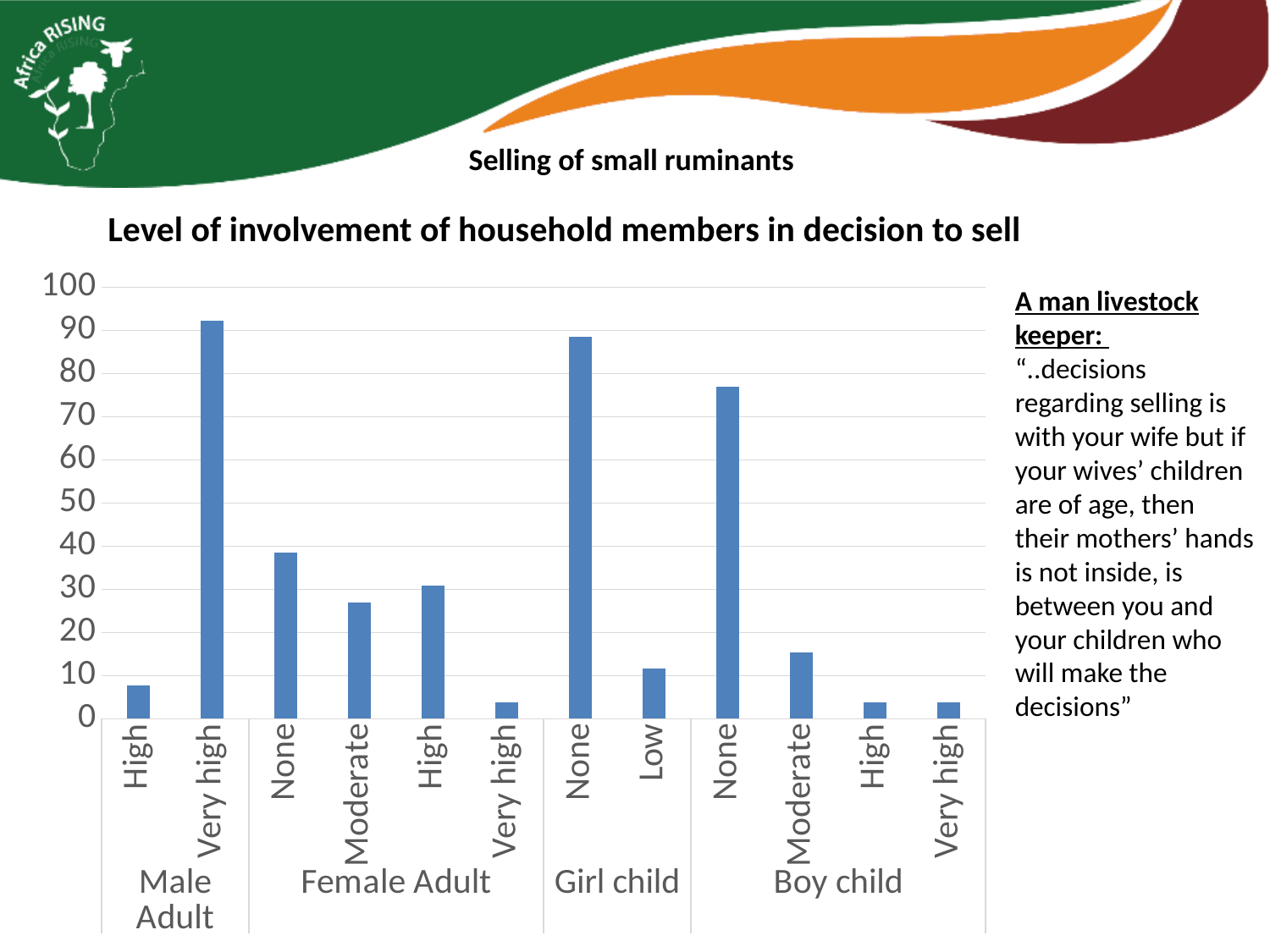
How many bars are plotted in the chart? 12 Is the value for Girl child 'Low' greater or less than 20? less Is the value for Male Adult 'Very high' greater or less than 80? greater What is the title of the chart? Level of involvement of household members in decision to sell Is the value for Male Adult 'High' greater or less than 20? less Within the Boy child group, which level of involvement has the highest bar? None Which is larger: Female Adult 'None' or Female Adult 'High'? Female Adult 'None' Within the Female Adult group, which level of involvement has the highest bar? None How many household member groups are shown along the x axis? 4 What type of chart is shown on the slide? bar chart Which bar is the highest in the chart? Male Adult, Very high